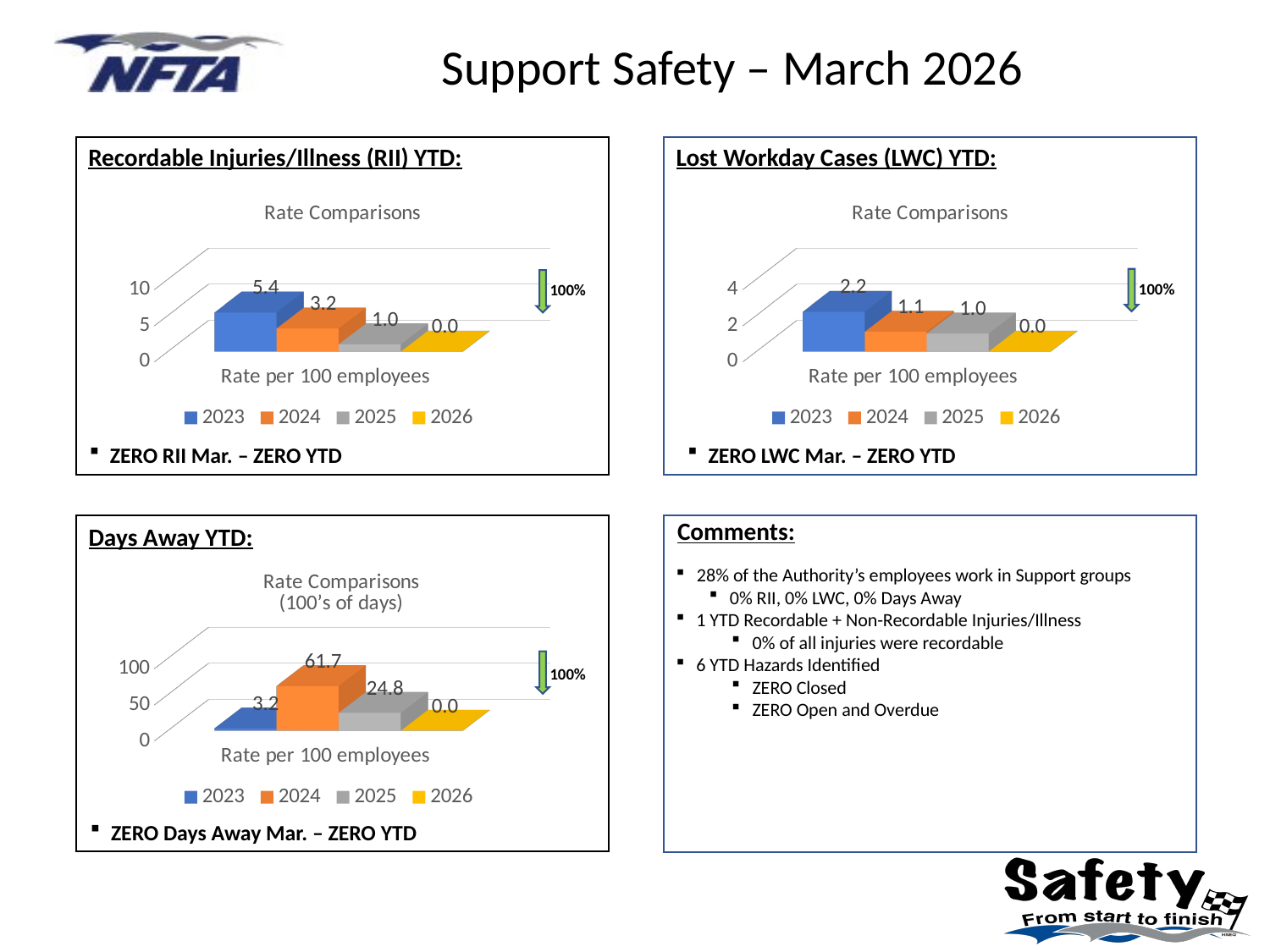
In the Days Away YTD chart, what is the difference between the 2024 and 2025 values? 36.9 In the Recordable Injuries/Illness (RII) YTD chart, what is the value for 2025? 1.0 In the Lost Workday Cases (LWC) YTD chart, what is the value for 2024? 1.1 In the Recordable Injuries/Illness (RII) YTD chart, what is the value for 2023? 5.4 In the Recordable Injuries/Illness (RII) YTD chart, which year has the highest value? 2023 What kind of chart is the Lost Workday Cases (LWC) YTD chart? Bar chart How many series does the legend of the Days Away YTD chart list? 4 In the Days Away YTD chart, which year has the highest value? 2024 In the Recordable Injuries/Illness (RII) YTD chart, what is the difference between the 2023 and 2024 values? 2.2 In the Lost Workday Cases (LWC) YTD chart, is the value for 2023 larger than the value for 2025? Yes In the Days Away YTD chart, what is the value for 2024? 61.7 In the Lost Workday Cases (LWC) YTD chart, which year has the lowest value? 2026